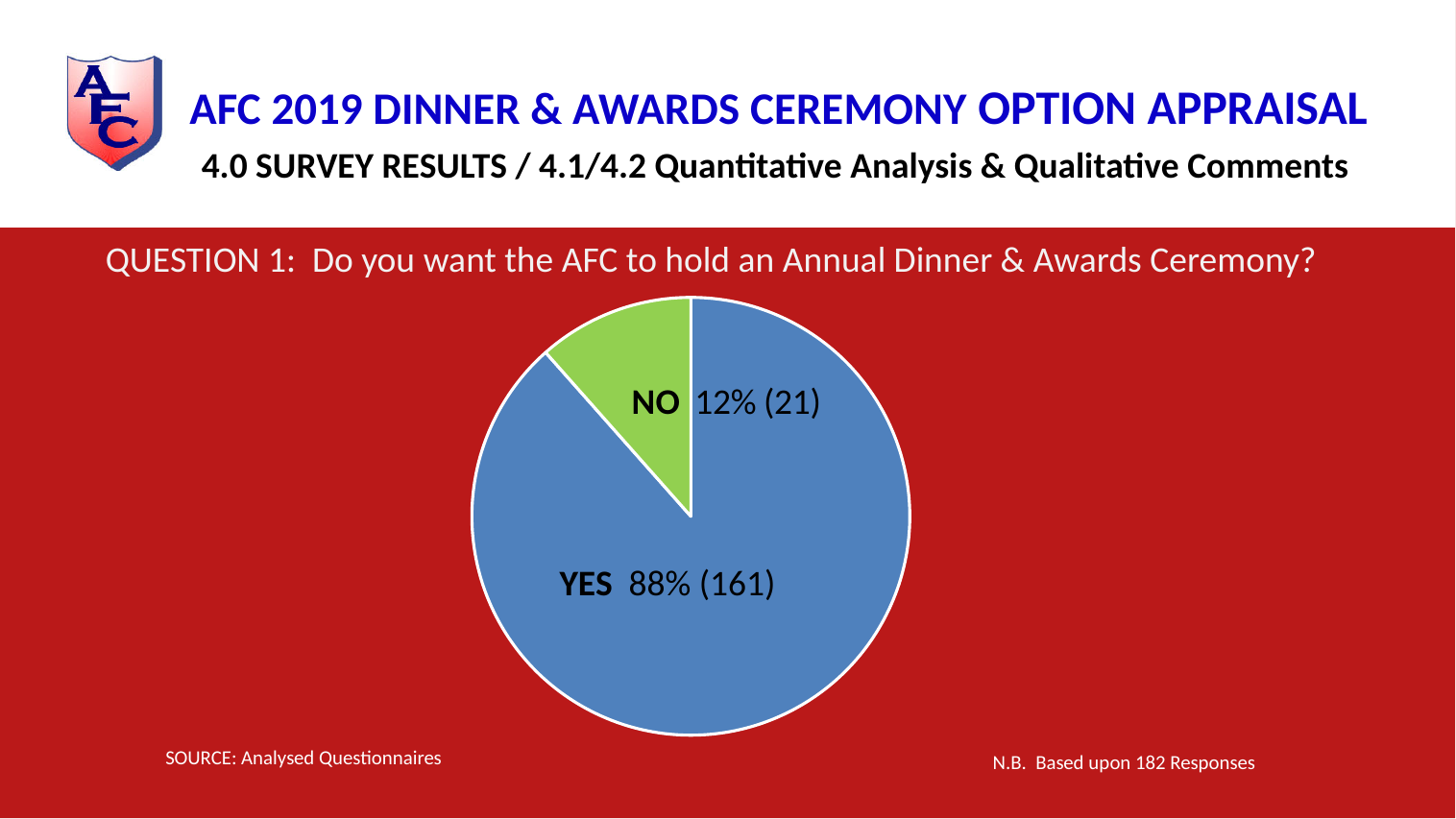
What percentage of respondents answered NO? 12% How many respondents answered NO? 21 Which response has the largest share of the pie? YES How many slices does the pie chart have? 2 Which is larger, the YES slice or the NO slice? YES What is the difference in percentage points between the YES and NO shares? 76 How many more respondents answered YES than NO? 140 Which response has the smallest share of the pie? NO What percentage of respondents answered YES? 88% What colour is the NO slice? green How many respondents answered YES? 161 What kind of chart is shown on the slide? pie chart